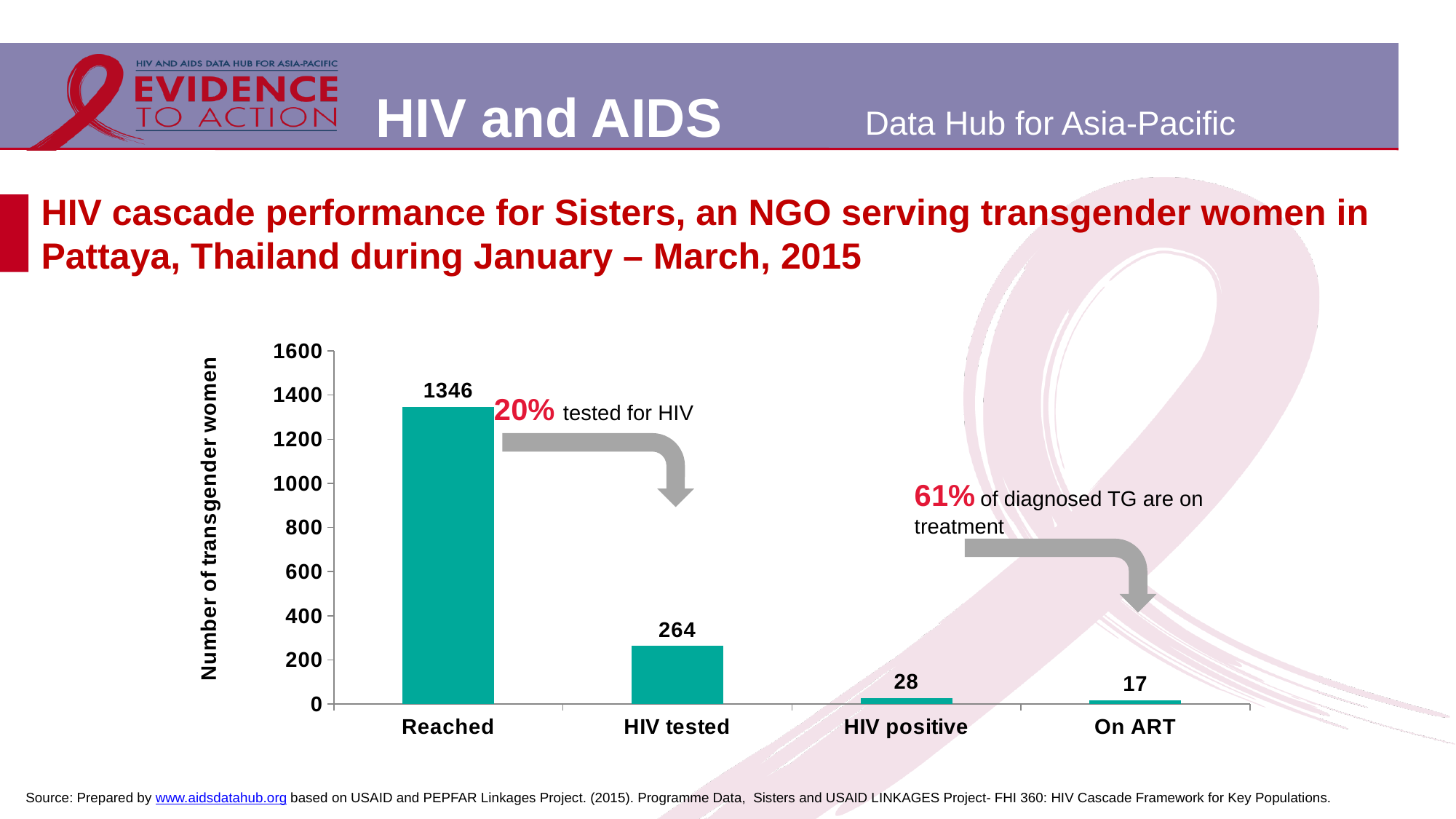
What is the value for HIV positive? 28 What is the value for HIV tested? 264 What is the number of transgender women reached? 1346 How many categories are shown on the x axis? 4 What is the value for On ART? 17 Which category has the lowest value? On ART Which is larger, the value for HIV tested or the value for HIV positive? HIV tested What is the difference between HIV positive and On ART? 11 What is the label of the y axis? Number of transgender women What kind of chart is shown on the slide? Bar chart What is the difference between the number reached and the number HIV tested? 1082 Which category has the highest value? Reached